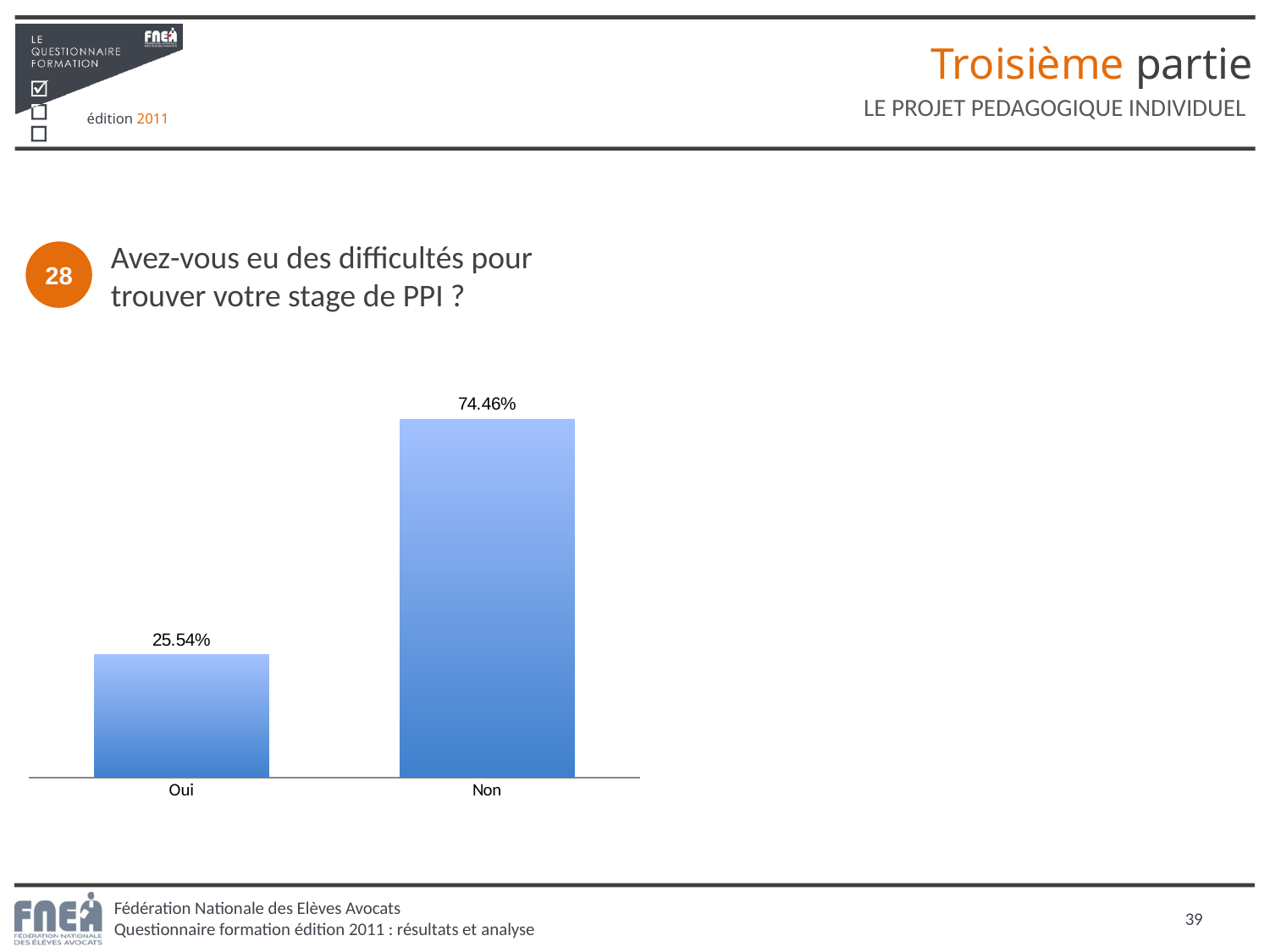
What colour are the bars in the chart? Blue How many categories are shown in the chart? 2 Which category has the lowest value? Oui What question does the chart on the slide answer? Avez-vous eu des difficultés pour trouver votre stage de PPI ? What is the total of the two values shown in the chart? 100% Which category has the highest value? Non What is the value for Non? 74.46% What is the difference between the values for Non and Oui? 48.92% What kind of chart is shown on the slide? Bar chart What is the value for Oui? 25.54% Which is larger, the value for Oui or the value for Non? Non